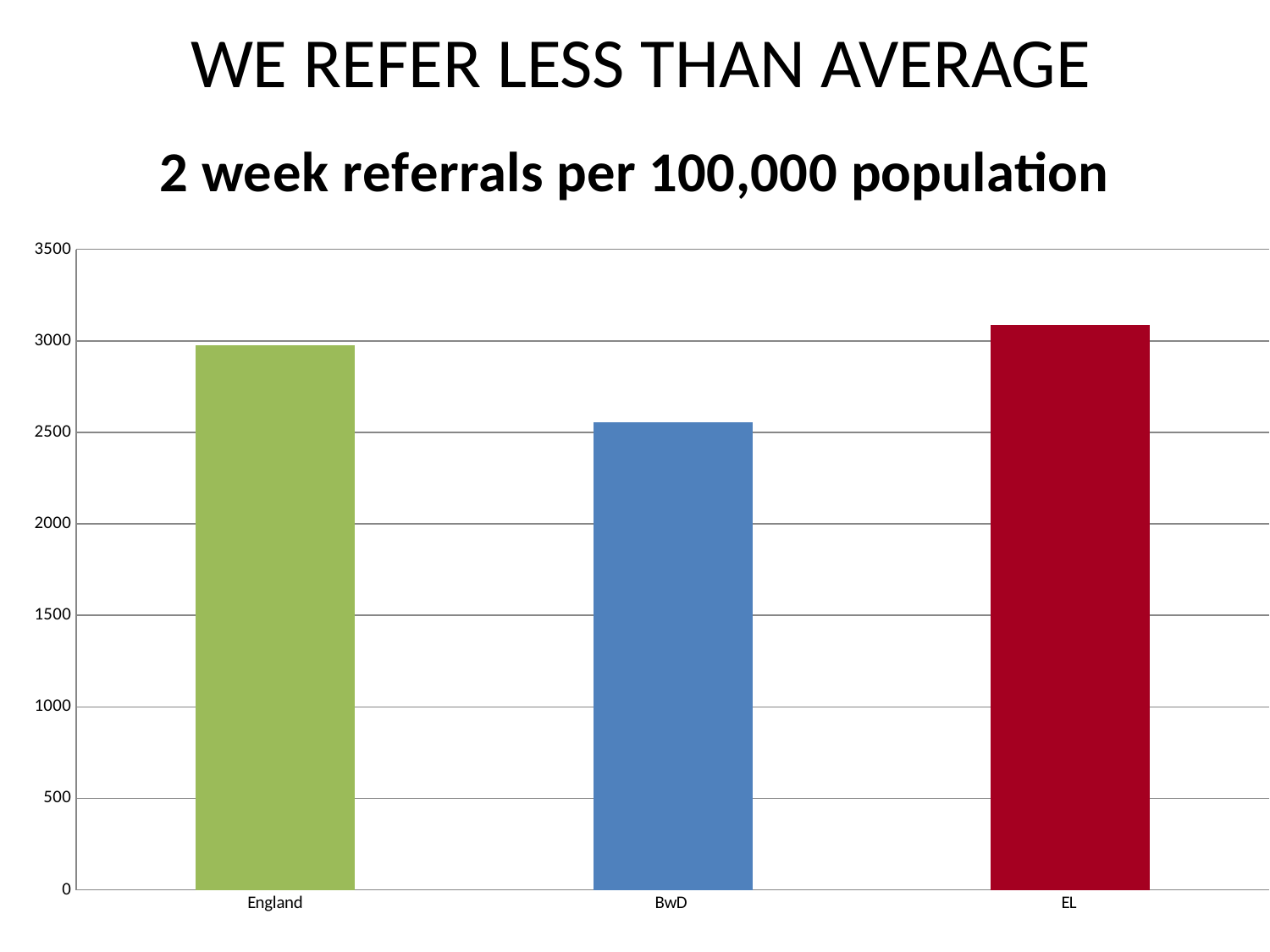
Which is larger, the value for BwD or the value for EL? EL How many categories are shown on the x axis? 3 What is the title of the chart? 2 week referrals per 100,000 population Which category has the lowest value? BwD What kind of chart is shown on the slide? bar chart Which is larger, the value for England or the value for BwD? England What colour is the bar for BwD? blue Is the value for England greater or less than 2500? greater Is the value for BwD greater or less than 2000? greater Is the value for BwD greater or less than 3000? less Which category has the highest value? EL